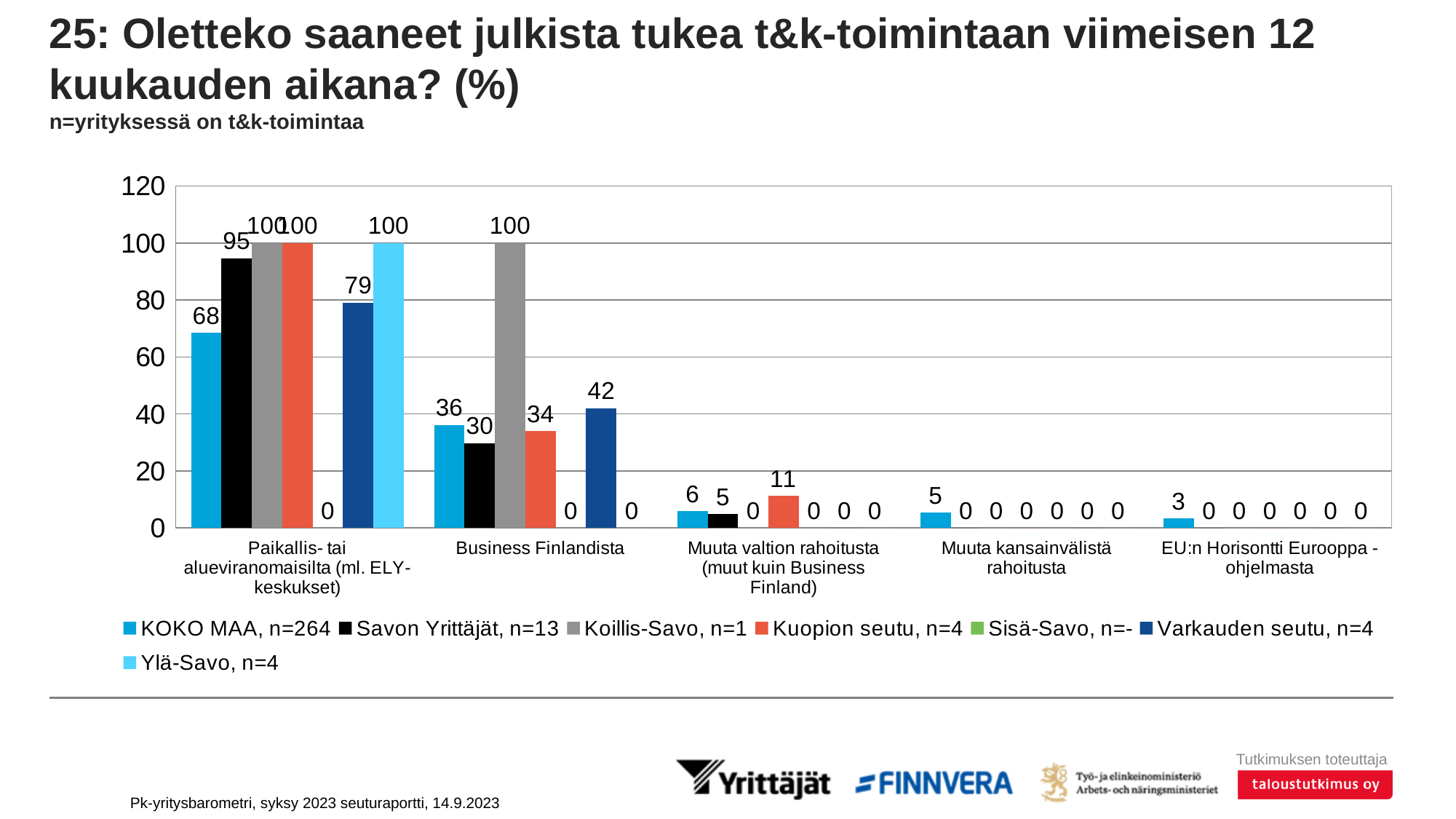
What is the value for KOKO MAA in the Paikallis- tai alueviranomaisilta (ml. ELY-keskukset) category? 68 In the Business Finlandista category, which is larger: the value for KOKO MAA or the value for Kuopion seutu? KOKO MAA What kind of chart is shown on the slide? Bar chart Which series has the lowest value in the Paikallis- tai alueviranomaisilta (ml. ELY-keskukset) category? Sisä-Savo What is the value for KOKO MAA in the EU:n Horisontti Eurooppa -ohjelmasta category? 3 What is the difference between the Savon Yrittäjät and KOKO MAA values in the Paikallis- tai alueviranomaisilta (ml. ELY-keskukset) category? 27 What is the value for Kuopion seutu in the Muuta valtion rahoitusta (muut kuin Business Finland) category? 11 How many series does the legend list? 7 Which series has the highest value in the Business Finlandista category? Koillis-Savo What is the value for Varkauden seutu in the Business Finlandista category? 42 How many categories are shown on the x axis? 5 Do the KOKO MAA values rise or fall from left to right across the categories? Fall